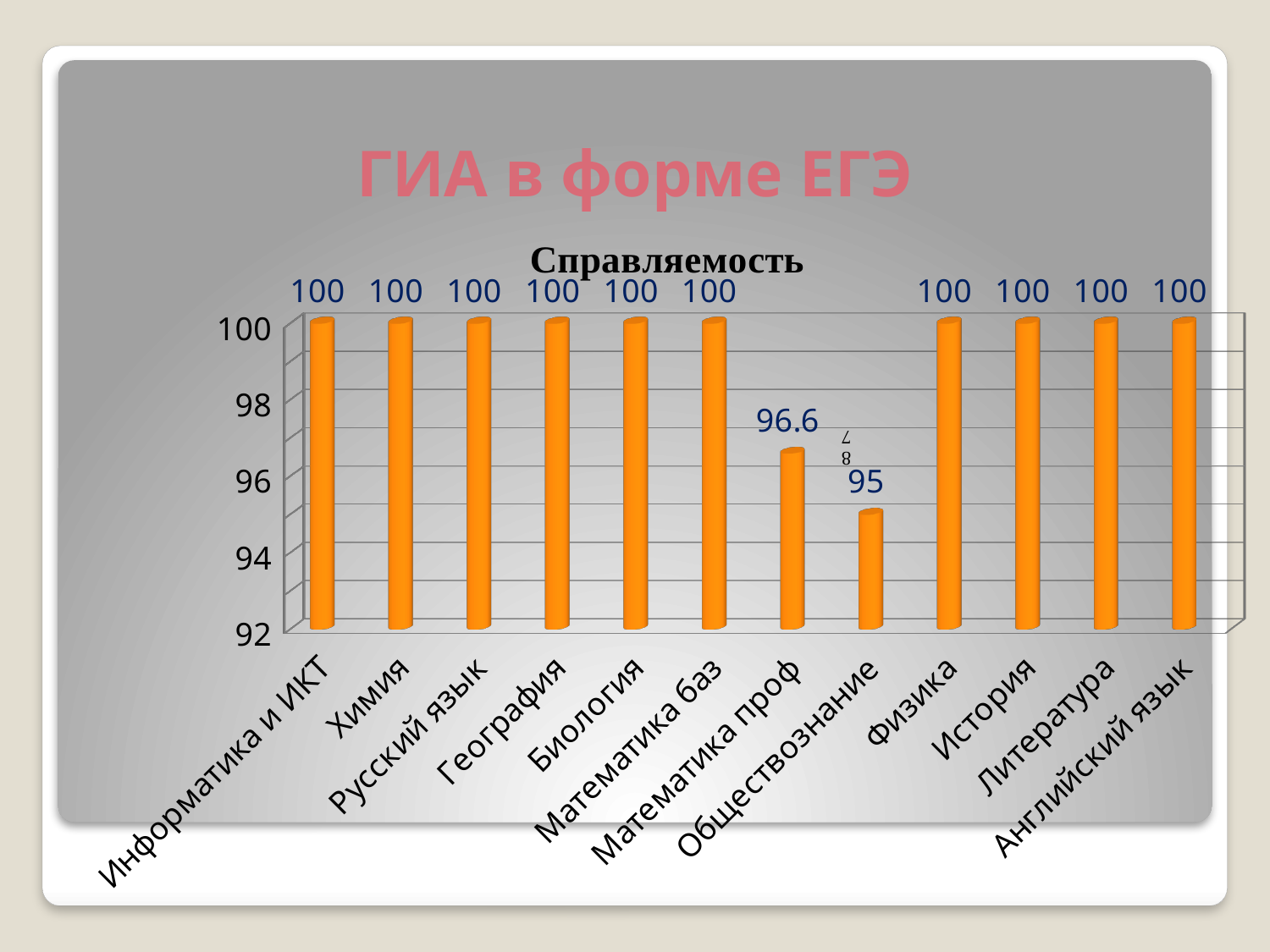
What colour are the bars in the chart? orange What is the value for Математика проф? 96.6 How many categories are plotted in the chart? 12 Which is larger, the value for Математика баз or the value for Математика проф? Математика баз What is the title of the chart? Справляемость What kind of chart is shown on the slide? bar chart Which category has the lowest value? Обществознание What is the value for Обществознание? 95 What is the value for Английский язык? 100 What is the value for Химия? 100 What is the difference between the values for Математика проф and Обществознание? 1.6 What is the difference between the values for Физика and Обществознание? 5